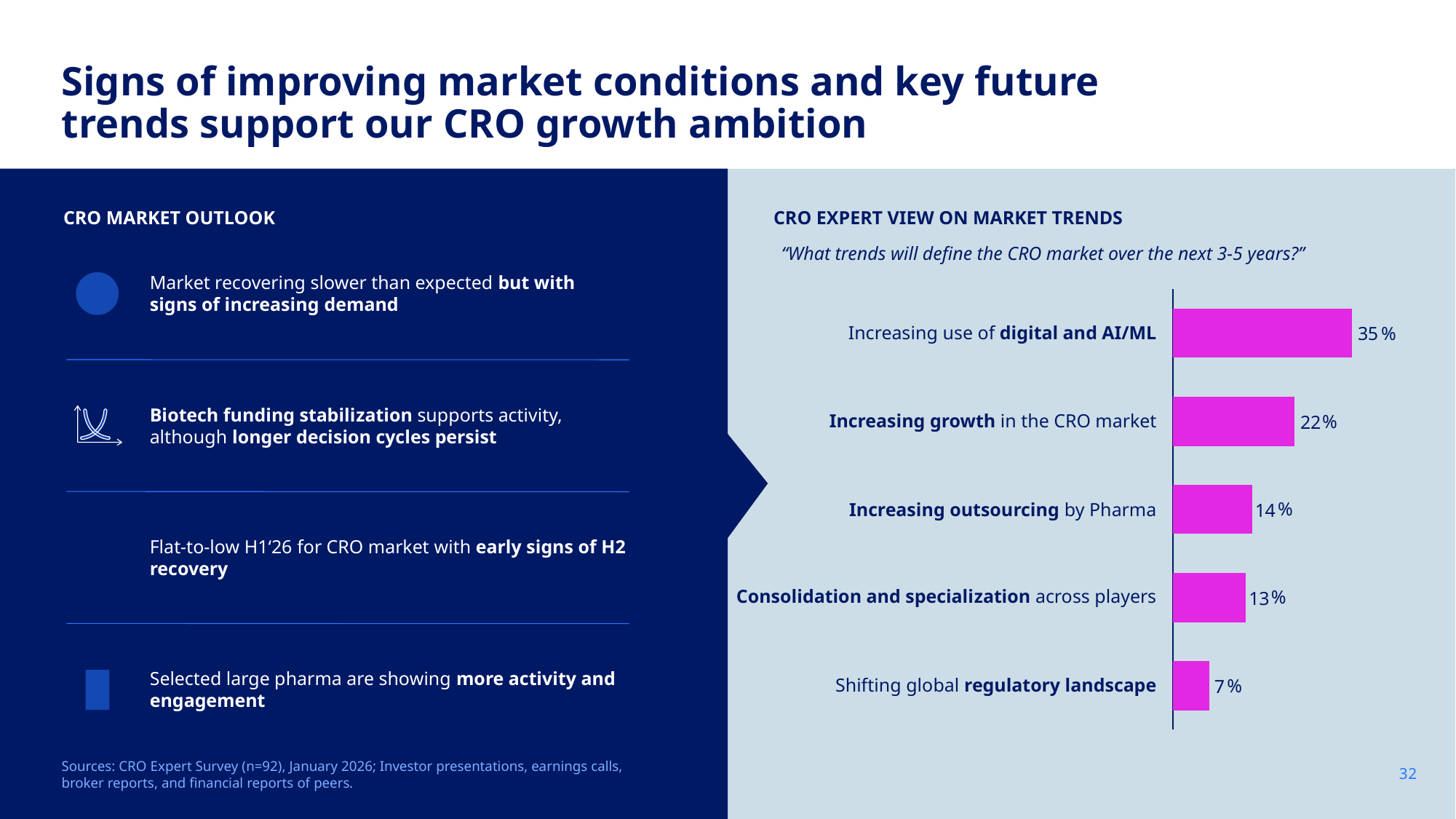
What survey question is shown above the CRO expert view chart? "What trends will define the CRO market over the next 3-5 years?" What percentage is shown for 'Increasing outsourcing by Pharma'? 14% What is the difference between the values for 'Consolidation and specialization across players' and 'Shifting global regulatory landscape'? 6 percentage points What type of chart is used to show the CRO expert view on market trends? Bar chart Which trend has the lowest percentage in the CRO expert view chart? Shifting global regulatory landscape What value is shown for 'Increasing growth in the CRO market'? 22% What percentage of CRO experts cited increasing use of digital and AI/ML as a trend that will define the CRO market? 35% How many trends are plotted in the CRO expert view chart? 5 Which trend has the highest percentage in the CRO expert view chart? Increasing use of digital and AI/ML Which has a higher value: 'Increasing outsourcing by Pharma' or 'Consolidation and specialization across players'? Increasing outsourcing by Pharma What is the difference in percentage points between 'Increasing use of digital and AI/ML' and 'Increasing growth in the CRO market'? 13 percentage points What value is shown for 'Shifting global regulatory landscape'? 7%